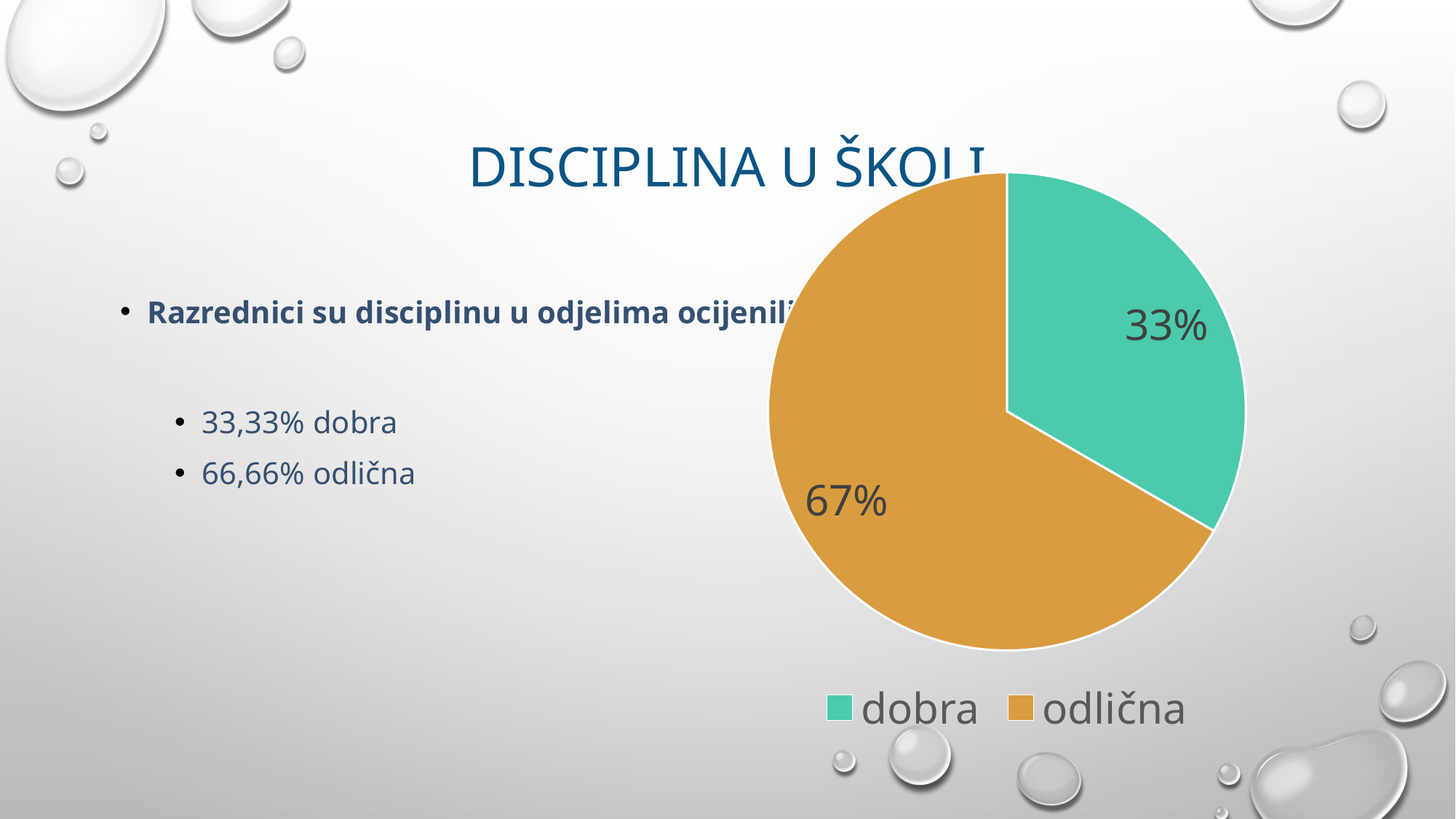
Which category has the largest slice of the pie? odlična What colour is the 'odlična' slice? orange What kind of chart is shown on the slide? pie chart Which slice is larger, 'dobra' or 'odlična'? odlična How many categories does the pie chart show? 2 What share of the pie does the 'dobra' slice represent? 33% Which category has the smallest slice of the pie? dobra What colour is the 'dobra' slice? teal What share of the pie does the 'odlična' slice represent? 67% How many entries does the legend list? 2 What is the difference in percentage points between the 'odlična' and 'dobra' slices? 34